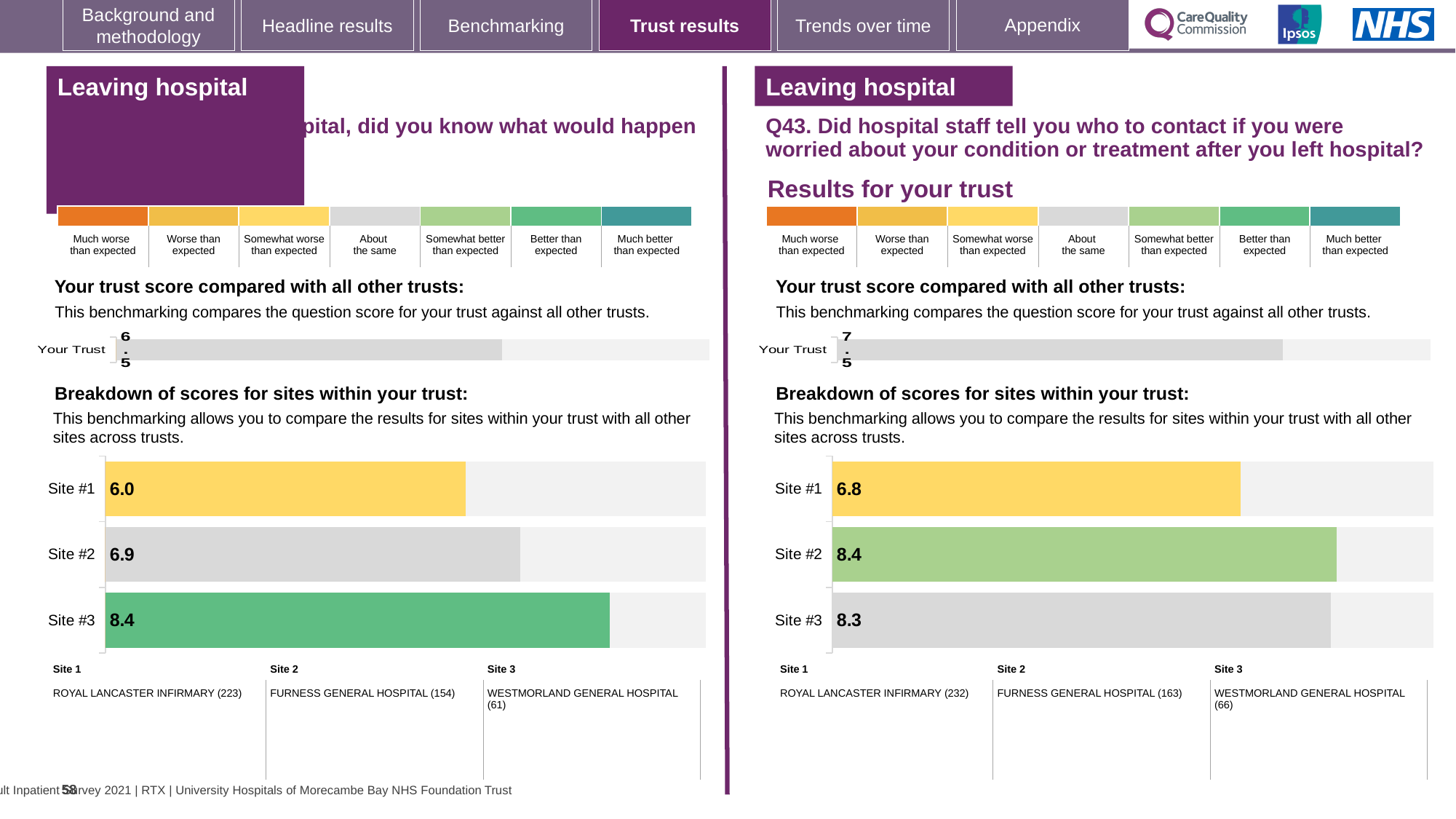
In the Q43 site breakdown chart on the right, what is the score for Site #2? 8.4 In the Q43 site breakdown chart on the right, which site has the lowest score? Site #1 In the left-hand panel, what is the 'Your Trust' score shown in the trust benchmarking bar? 6.5 In the Q43 site breakdown chart on the right, what is the difference between the scores for Site #2 and Site #1? 1.6 How many sites are shown in the Q43 site breakdown chart on the right? 3 In the Q43 site breakdown chart on the right, what is the score for Site #1? 6.8 In the Q43 panel on the right, what is the 'Your Trust' score shown in the trust benchmarking bar? 7.5 In the left-hand site breakdown chart, which site has the lowest score? Site #1 In the left-hand site breakdown chart, what is the score for Site #3? 8.4 In the left-hand site breakdown chart, what is the difference between the scores for Site #3 and Site #2? 1.5 In the left-hand site breakdown chart, what is the score for Site #1? 6.0 In the left-hand site breakdown chart, which site has the highest score? Site #3